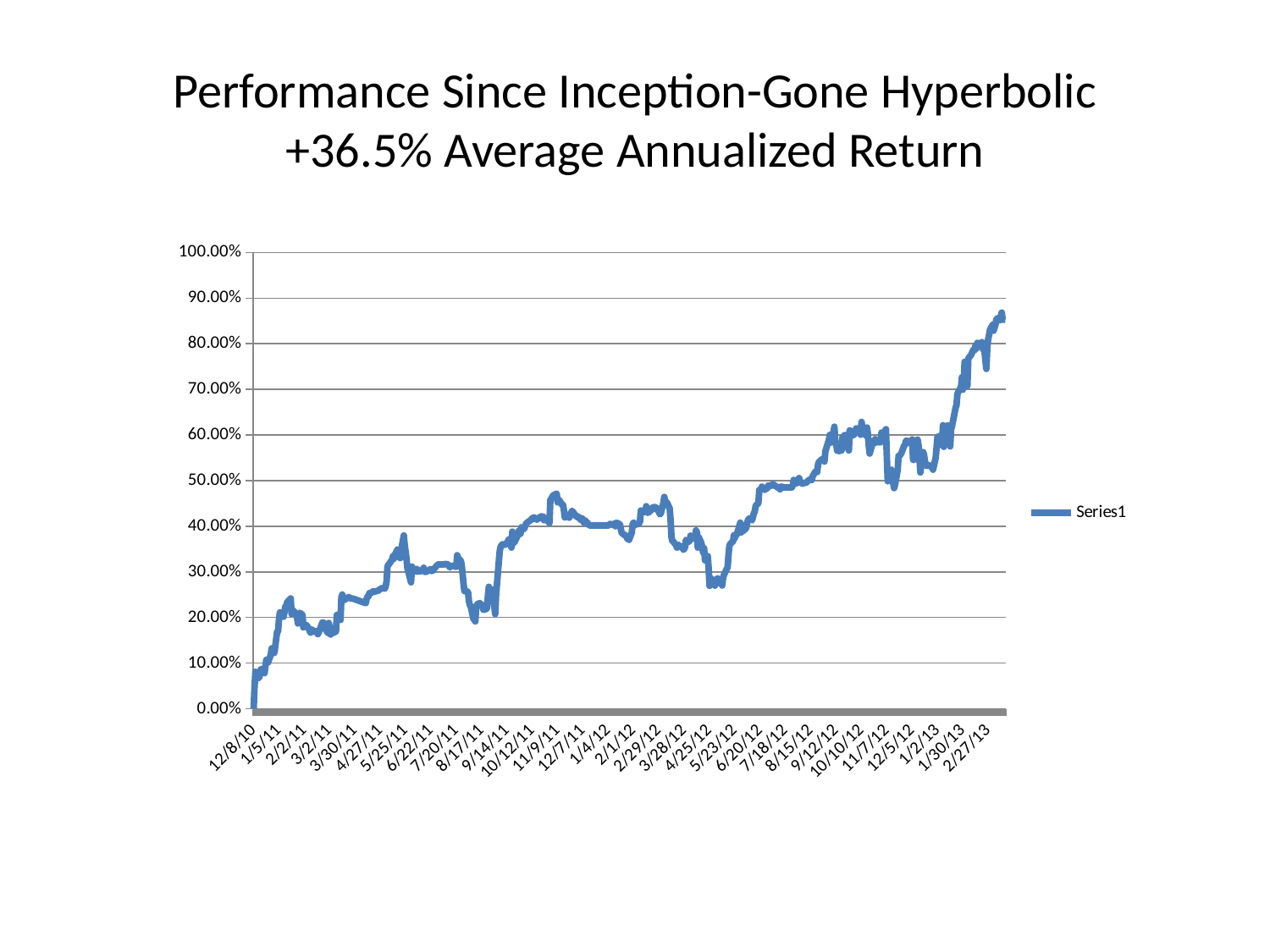
Overall, do the values rise or fall from 12/8/10 to 2/27/13? Rise Which is larger, the value at 2/27/13 or the value at 12/8/10? 2/27/13 What is the title of the slide above the chart? Performance Since Inception-Gone Hyperbolic +36.5% Average Annualized Return Near which x-axis date does the line reach its highest value? 2/27/13 What kind of chart is shown on the slide? Line chart What is the name of the series shown in the legend? Series1 How many series does the legend list? 1 Is the value at 1/30/13 greater or less than 60%? greater Is the value at 12/8/10 greater or less than 10%? less Is the value at 8/17/11 greater or less than 30%? less